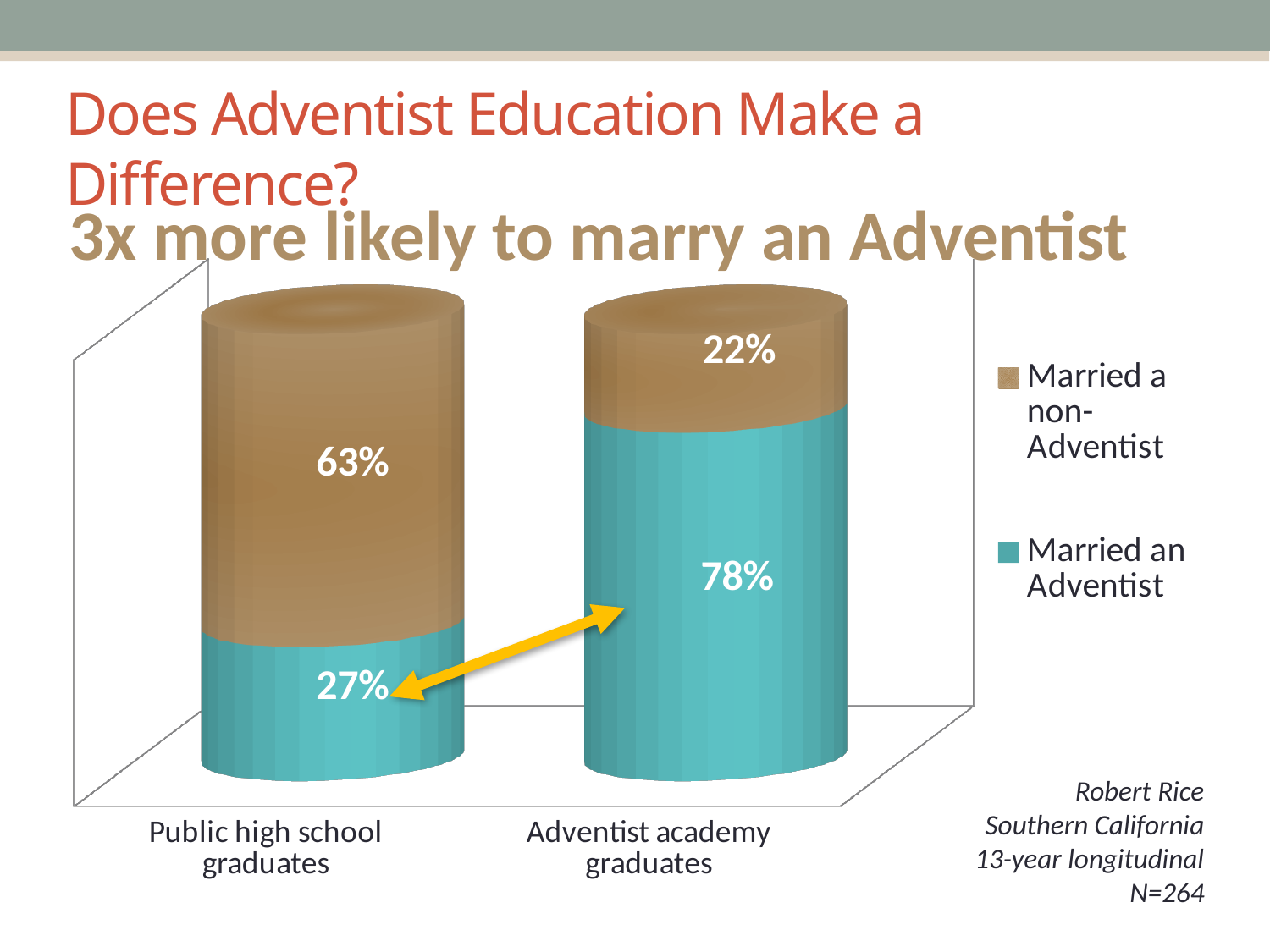
Which group has the higher share who married an Adventist? Adventist academy graduates Which group has the lower share who married a non-Adventist? Adventist academy graduates What percentage of public high school graduates married a non-Adventist? 63% What percentage of Adventist academy graduates married a non-Adventist? 22% What percentage of Adventist academy graduates married an Adventist? 78% What is the title of the chart? 3x more likely to marry an Adventist What percentage of public high school graduates married an Adventist? 27% How many series does the legend list? 2 What is the difference in percentage points between the share of Adventist academy graduates and public high school graduates who married an Adventist? 51 How many categories are shown on the x axis of the chart? 2 Is the 'Married a non-Adventist' value larger for public high school graduates or Adventist academy graduates? Public high school graduates What kind of chart is shown on the slide? Stacked bar chart